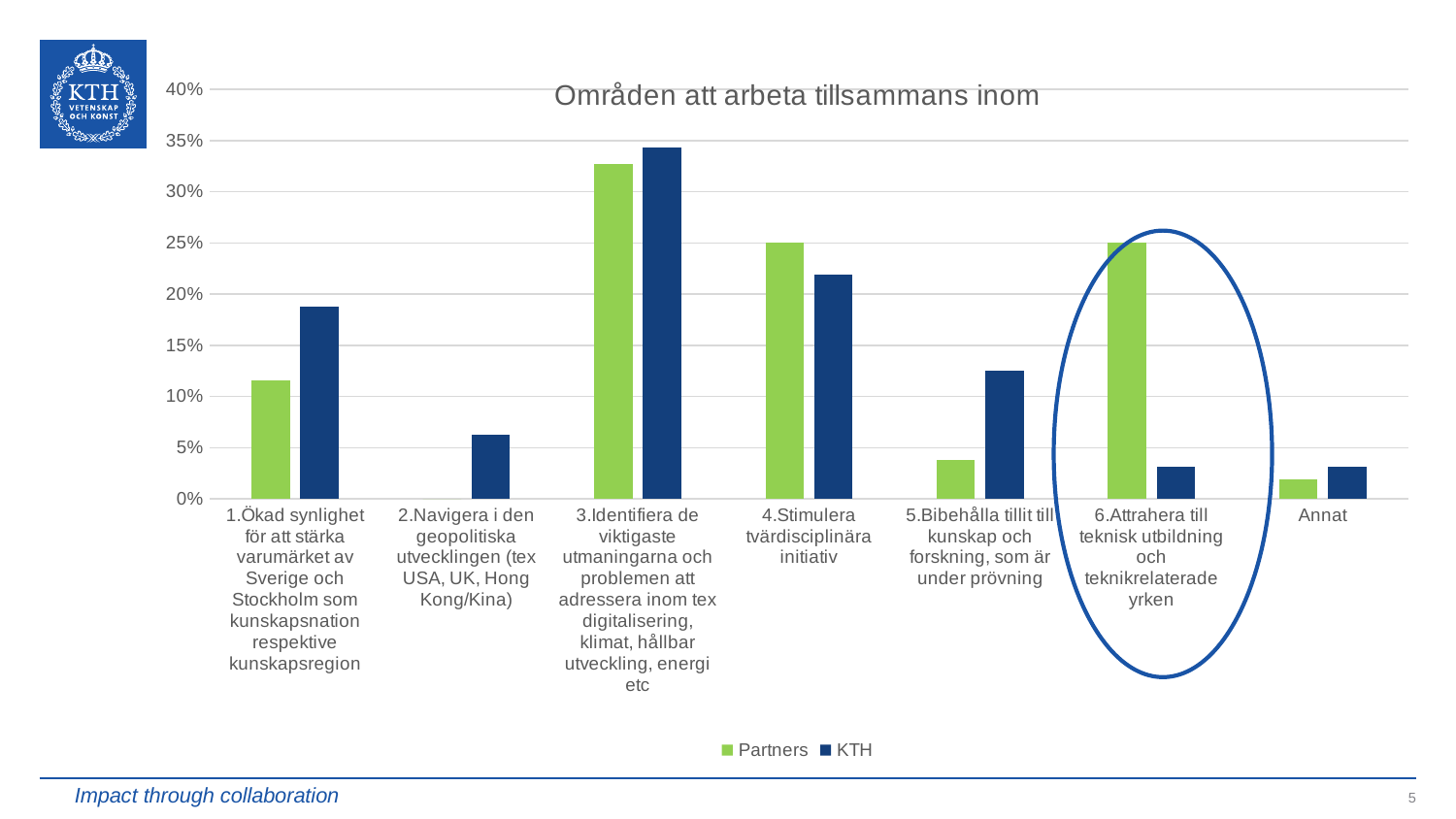
Is the KTH value for "1.Ökad synlighet för att stärka varumärket av Sverige och Stockholm som kunskapsnation respektive kunskapsregion" greater or less than 15%? greater Which category has the lowest value for Partners? 2.Navigera i den geopolitiska utvecklingen (tex USA, UK, Hong Kong/Kina) Is the KTH value for "5.Bibehålla tillit till kunskap och forskning, som är under prövning" greater or less than 10%? greater Which category has the highest value for Partners? 3.Identifiera de viktigaste utmaningarna och problemen att adressera inom tex digitalisering, klimat, hållbar utveckling, energi etc How many series does the legend list? 2 For "6.Attrahera till teknisk utbildning och teknikrelaterade yrken", which series has the larger value, Partners or KTH? Partners What is the title of the chart? Områden att arbeta tillsammans inom What kind of chart is shown on the slide? Bar chart Which category on the chart is highlighted with a blue ellipse? 6.Attrahera till teknisk utbildning och teknikrelaterade yrken Is the Partners value for "5.Bibehålla tillit till kunskap och forskning, som är under prövning" greater or less than 5%? less Which category has the highest value for KTH? 3.Identifiera de viktigaste utmaningarna och problemen att adressera inom tex digitalisering, klimat, hållbar utveckling, energi etc How many categories are shown on the x axis? 7